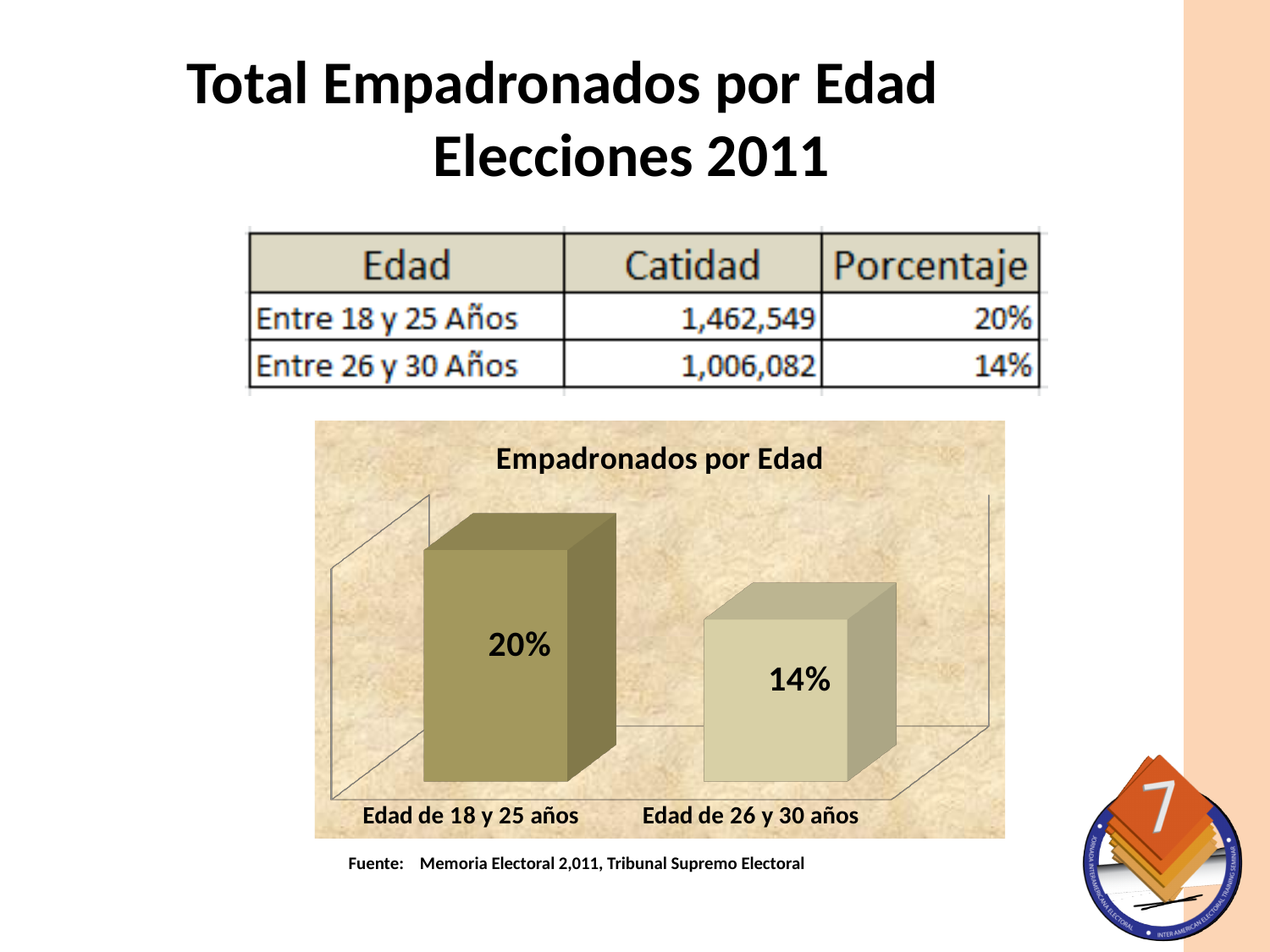
What is the difference between the values for 'Edad de 18 y 25 años' and 'Edad de 26 y 30 años'? 6% Which is larger: the value for 'Edad de 18 y 25 años' or 'Edad de 26 y 30 años'? Edad de 18 y 25 años Which category has the lowest value in the chart? Edad de 26 y 30 años Which category has the highest value in the chart? Edad de 18 y 25 años What is the value shown for 'Edad de 26 y 30 años' in the chart? 14% How many categories are plotted in the chart? 2 What is the value shown for 'Edad de 18 y 25 años' in the chart? 20% What source is cited below the chart? Memoria Electoral 2,011, Tribunal Supremo Electoral Do the values rise or fall from left to right across the categories? Fall What kind of chart is shown on the slide? Bar chart What is the title of the chart? Empadronados por Edad